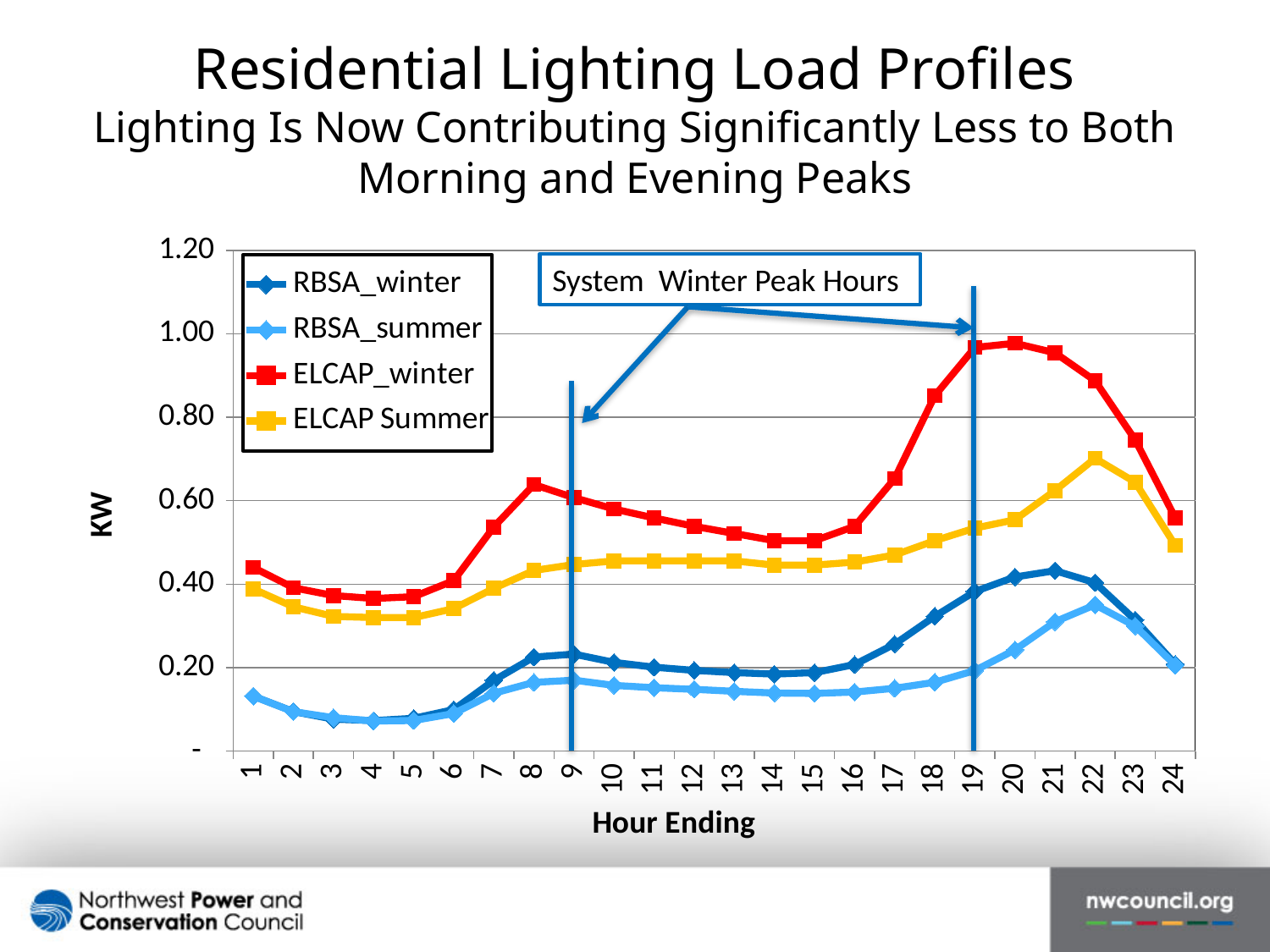
How many series does the legend list? 4 What kind of chart is shown on the slide? line chart Is the RBSA_winter value at hour 21 greater or less than 0.60? less What is the label on the y axis? KW What is the title of the x axis? Hour Ending Is the ELCAP_winter value at hour 20 greater or less than 0.80? greater Does the ELCAP_winter series rise or fall from hour 20 to hour 24? fall Which series has the lowest values across the chart? RBSA_summer At hour 22, which is larger: ELCAP Summer or RBSA_winter? ELCAP Summer Which series reaches the highest value on the chart? ELCAP_winter At which hour does the ELCAP Summer series reach its highest value? 22 How many hours are plotted along the x axis? 24